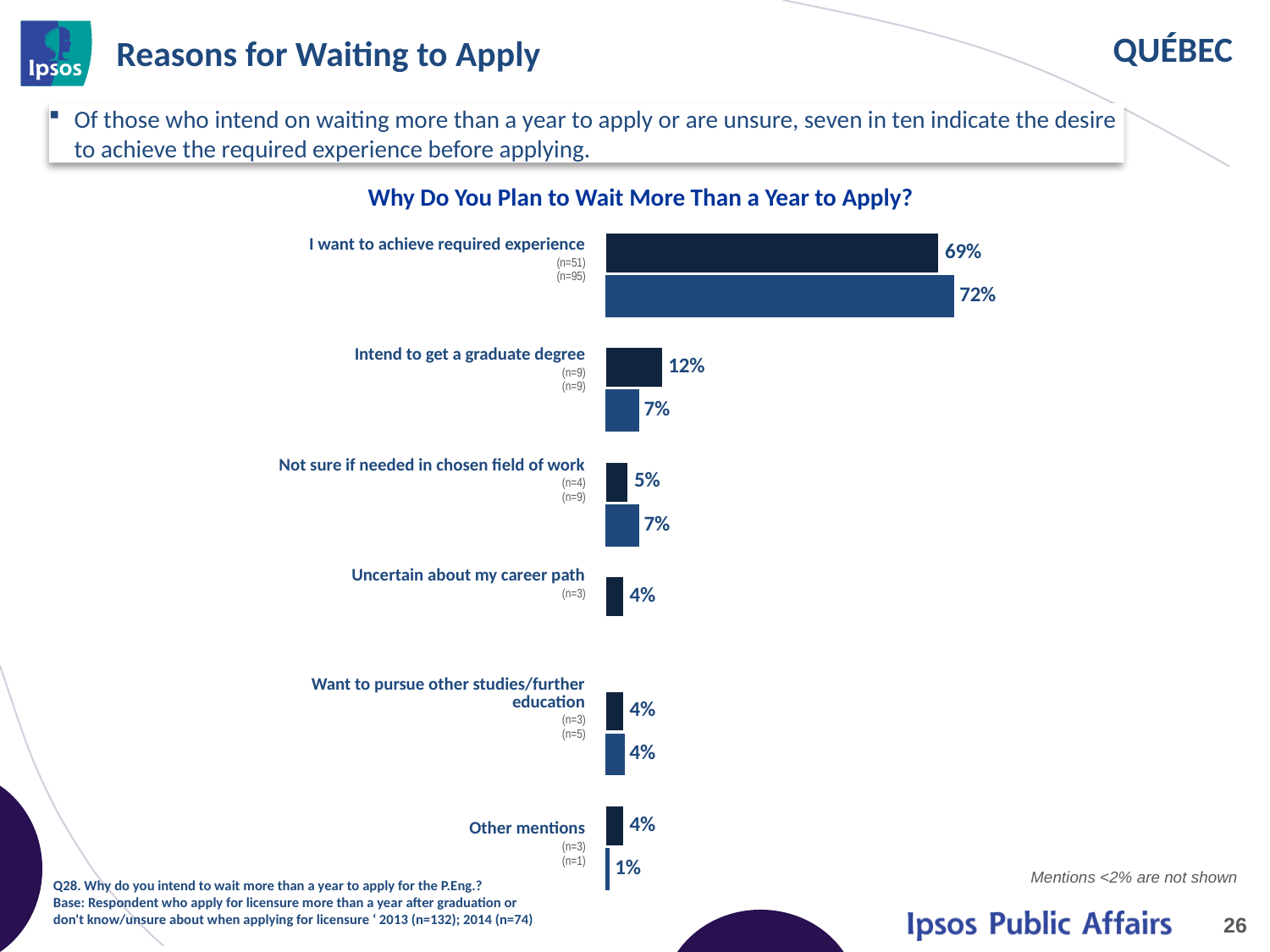
What is the value of the lighter blue (bottom) bar for 'Not sure if needed in chosen field of work'? 7% For 'Intend to get a graduate degree', which bar is larger, the dark navy (top) bar or the lighter blue (bottom) bar? dark navy (top) bar What is the value of the lighter blue (bottom) bar for 'Other mentions'? 1% What is the difference between the lighter blue bar and the dark navy bar for 'I want to achieve required experience'? 3% What is the value of the dark navy (top) bar for 'Intend to get a graduate degree'? 12% What is the title of the chart? Why Do You Plan to Wait More Than a Year to Apply? How many reason categories are plotted in the chart? 6 Which category has the highest value in the chart? I want to achieve required experience What is the value of the lighter blue (bottom) bar for 'I want to achieve required experience'? 72% What is the difference between the dark navy bar for 'Intend to get a graduate degree' and the dark navy bar for 'Not sure if needed in chosen field of work'? 7% What is the value of the dark navy (top) bar for 'I want to achieve required experience'? 69% What kind of chart is shown on the slide? bar chart